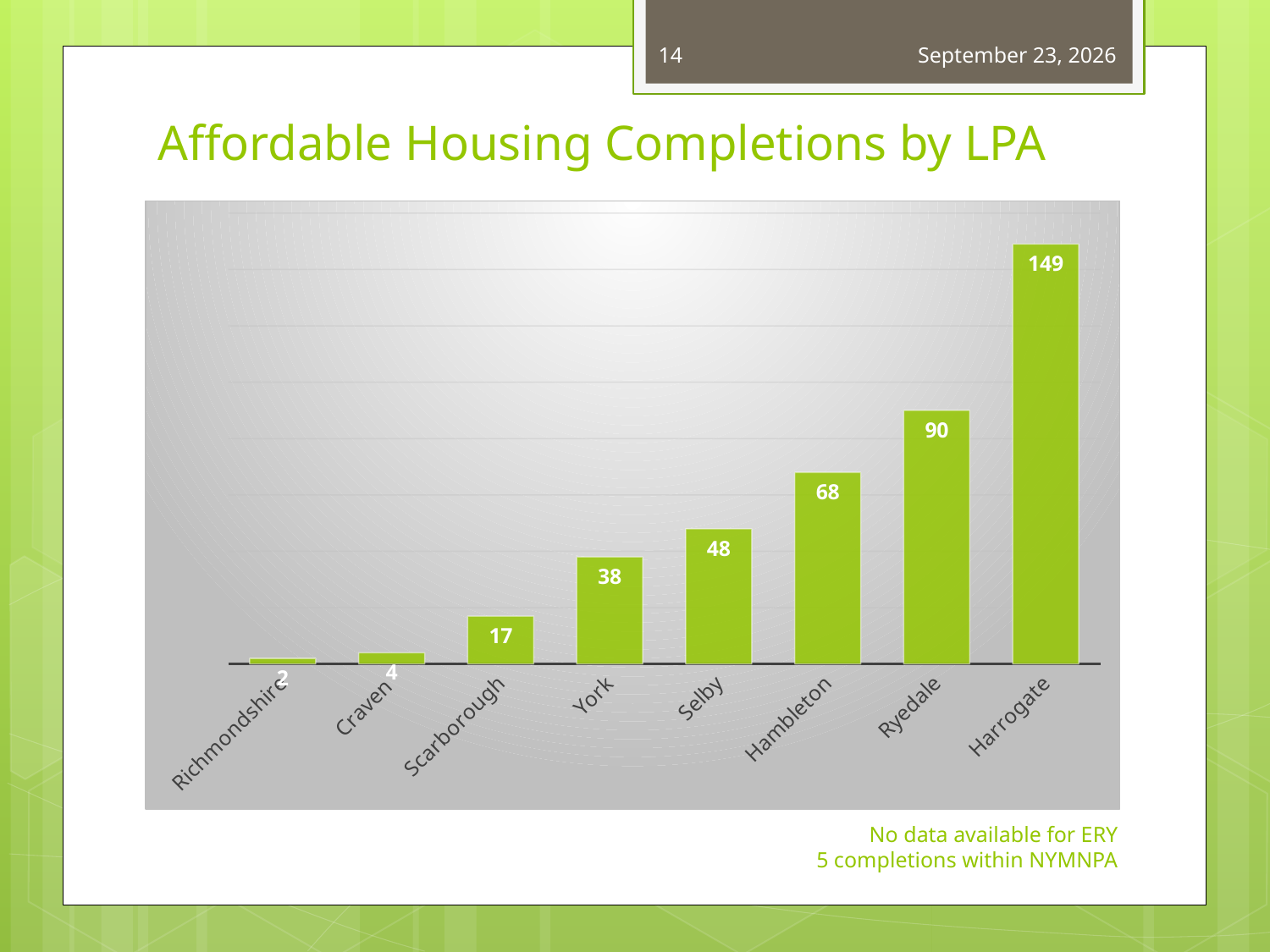
What is the difference between the values for Hambleton and York? 30 Which is larger, the value for Selby or the value for Hambleton? Hambleton Which LPA has the lowest number of affordable housing completions? Richmondshire How many LPAs are shown on the chart? 8 What is the title of the chart? Affordable Housing Completions by LPA Which LPA has the highest number of affordable housing completions? Harrogate What is the value for Harrogate? 149 What is the difference between the values for Harrogate and Ryedale? 59 What is the value for Selby? 48 Do the values rise or fall from left to right along the x axis? Rise What is the value for Scarborough? 17 What kind of chart is shown on the slide? Bar chart